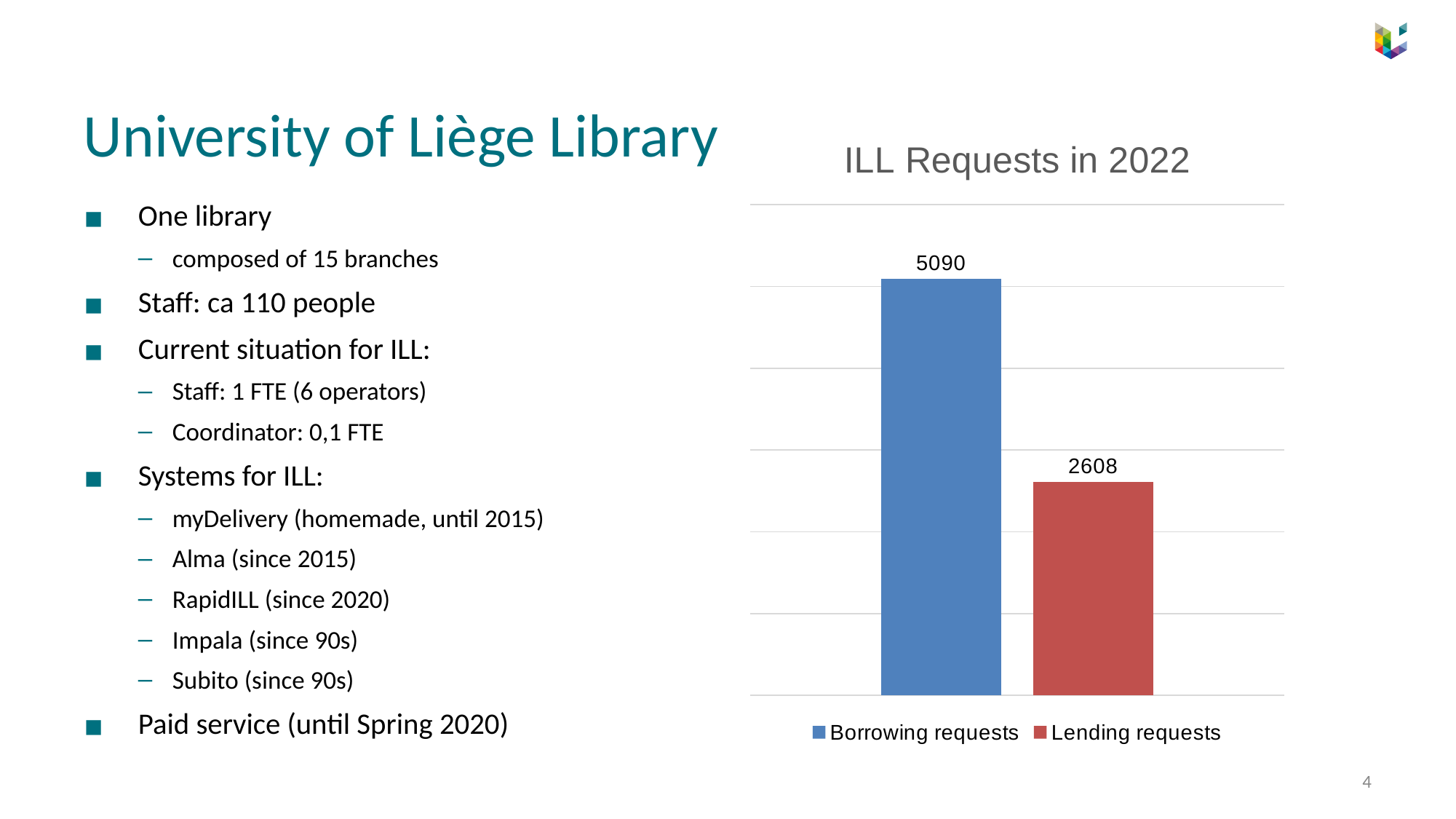
What is the difference between Borrowing requests and Lending requests in the ILL Requests in 2022 chart? 2482 What is the value for Borrowing requests in the ILL Requests in 2022 chart? 5090 How many bars are plotted in the ILL Requests in 2022 chart? 2 Which is larger in the ILL Requests in 2022 chart: Borrowing requests or Lending requests? Borrowing requests What is the value for Lending requests in the ILL Requests in 2022 chart? 2608 What is the title of the chart on the slide? ILL Requests in 2022 What kind of chart is shown on the slide? Bar chart How many series does the legend of the ILL Requests in 2022 chart list? 2 Which series has the lowest value in the ILL Requests in 2022 chart? Lending requests Which series has the highest value in the ILL Requests in 2022 chart? Borrowing requests What is the total of Borrowing requests and Lending requests in the ILL Requests in 2022 chart? 7698 What colour is the Lending requests bar in the ILL Requests in 2022 chart? Red